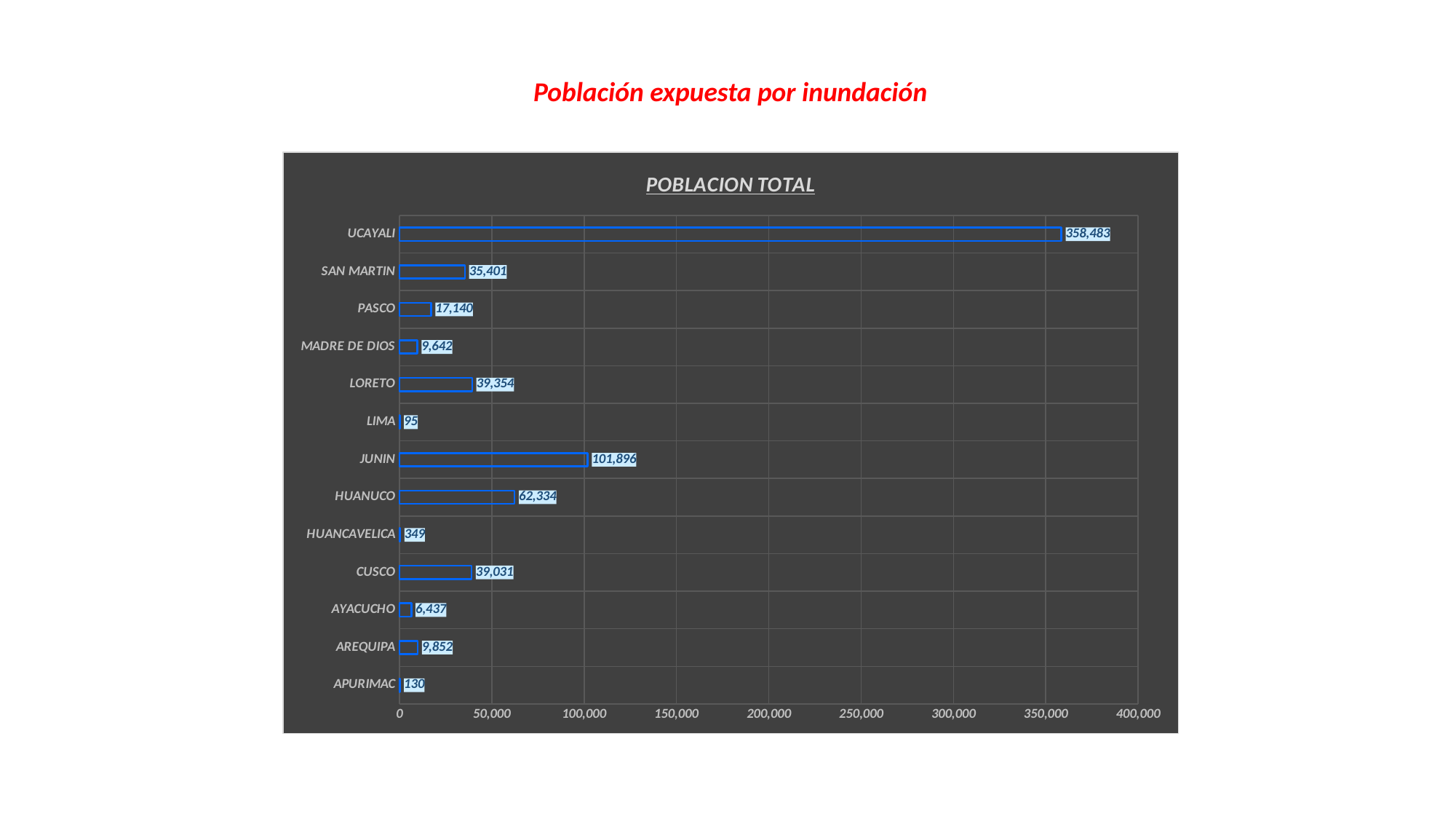
Which is larger, the value for LORETO or the value for CUSCO? LORETO What is the value for UCAYALI? 358,483 Which category has the lowest value? LIMA What is the difference between the values for SAN MARTIN and PASCO? 18,261 What is the value for JUNIN? 101,896 Which category has the highest value? UCAYALI Is the value for UCAYALI greater or less than 350,000? greater What is the difference between the values for JUNIN and HUANUCO? 39,562 What is the value for LIMA? 95 How many categories are shown in the chart? 13 What is the title of the chart? POBLACION TOTAL What kind of chart is shown on the slide? bar chart